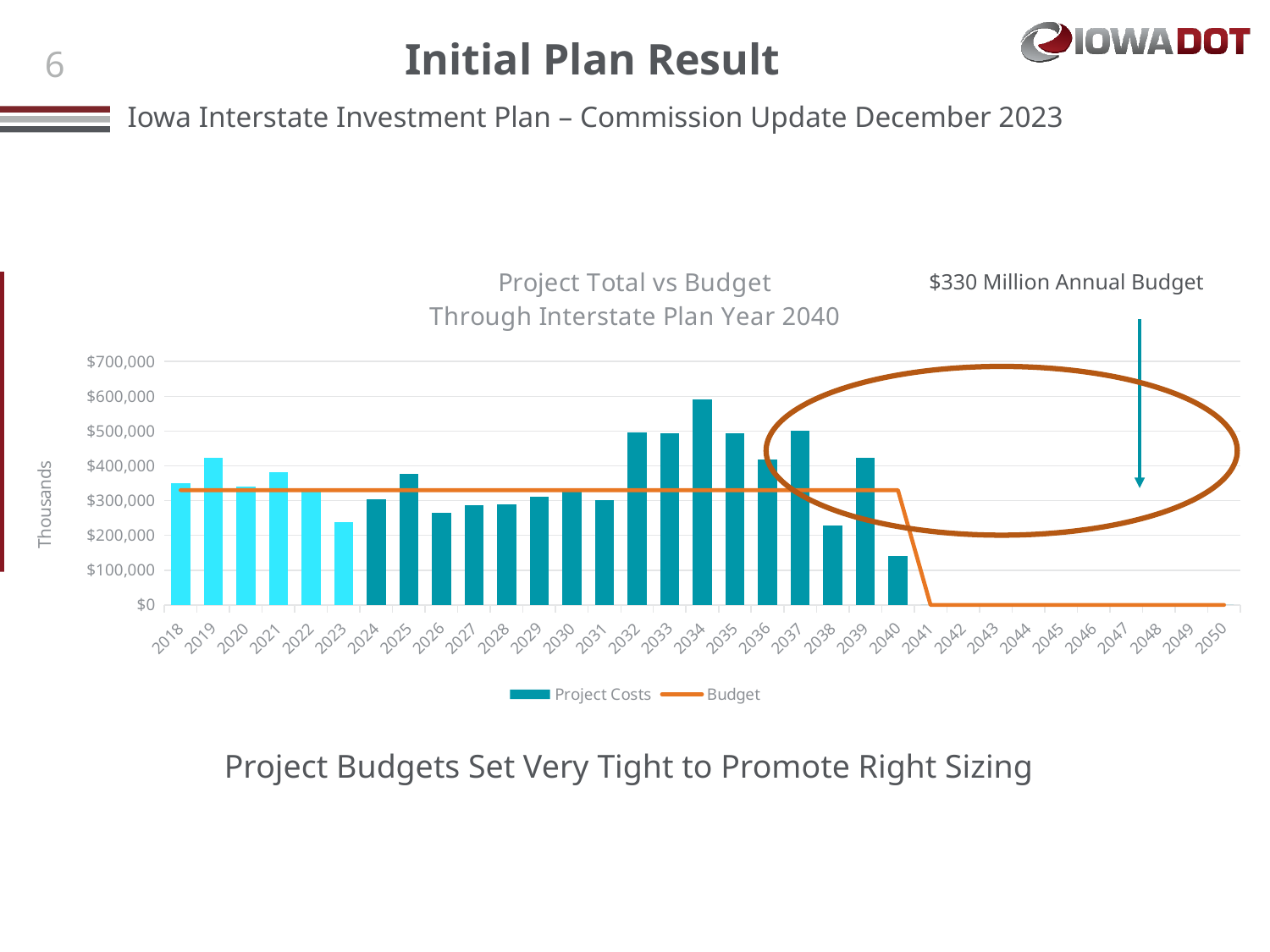
How many series does the chart legend list? 2 Is the Project Costs value for 2023 greater or less than $300,000? less Is the Project Costs value for 2034 greater or less than $500,000? greater What annual budget amount is stated in the annotation above the chart? $330 Million Annual Budget Which year has the larger Project Costs bar, 2037 or 2038? 2037 Which year has the highest Project Costs bar? 2034 Which year has the larger Project Costs bar, 2019 or 2018? 2019 Among the years with a Project Costs bar, which year has the lowest bar? 2040 Is the Project Costs value for 2040 greater or less than $200,000? less How many years are labelled along the x axis of the chart? 33 What are the two series named in the chart legend? Project Costs and Budget What kind of chart is shown on the slide? Bar chart with a line